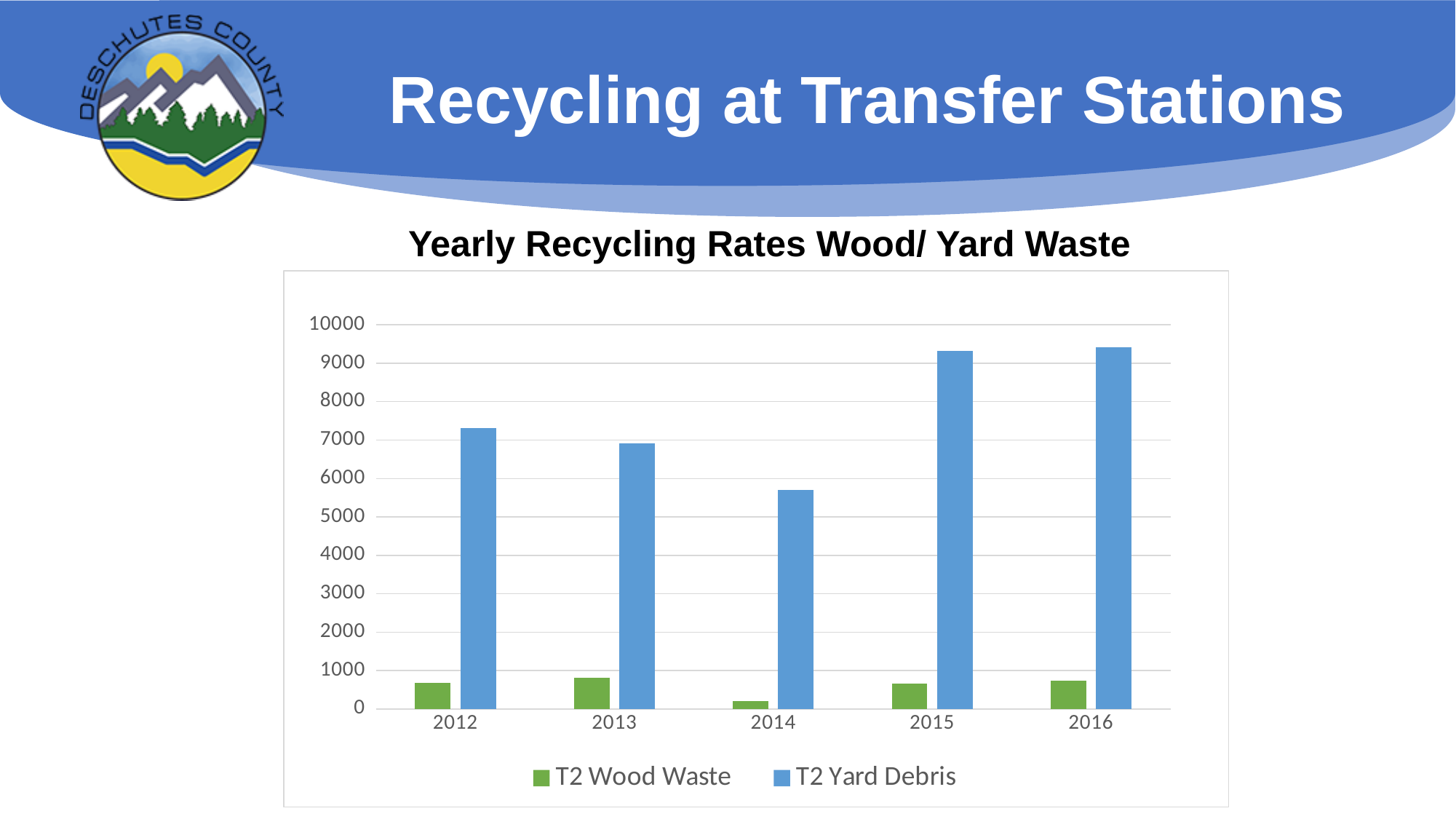
Which year has the lowest value for T2 Yard Debris? 2014 Which year has the lowest value for T2 Wood Waste? 2014 Is the value for T2 Wood Waste in 2013 greater or less than 1000? less Is the value for T2 Yard Debris in 2015 greater or less than 9000? greater Which is larger, T2 Yard Debris in 2014 or T2 Yard Debris in 2015? 2015 Is the value for T2 Yard Debris in 2012 greater or less than 7000? greater What type of chart is shown on the slide? Bar chart What is the title of the chart? Yearly Recycling Rates Wood/ Yard Waste How many years are shown on the x axis? 5 Which is larger, T2 Yard Debris in 2012 or T2 Yard Debris in 2013? 2012 How many series does the legend list? 2